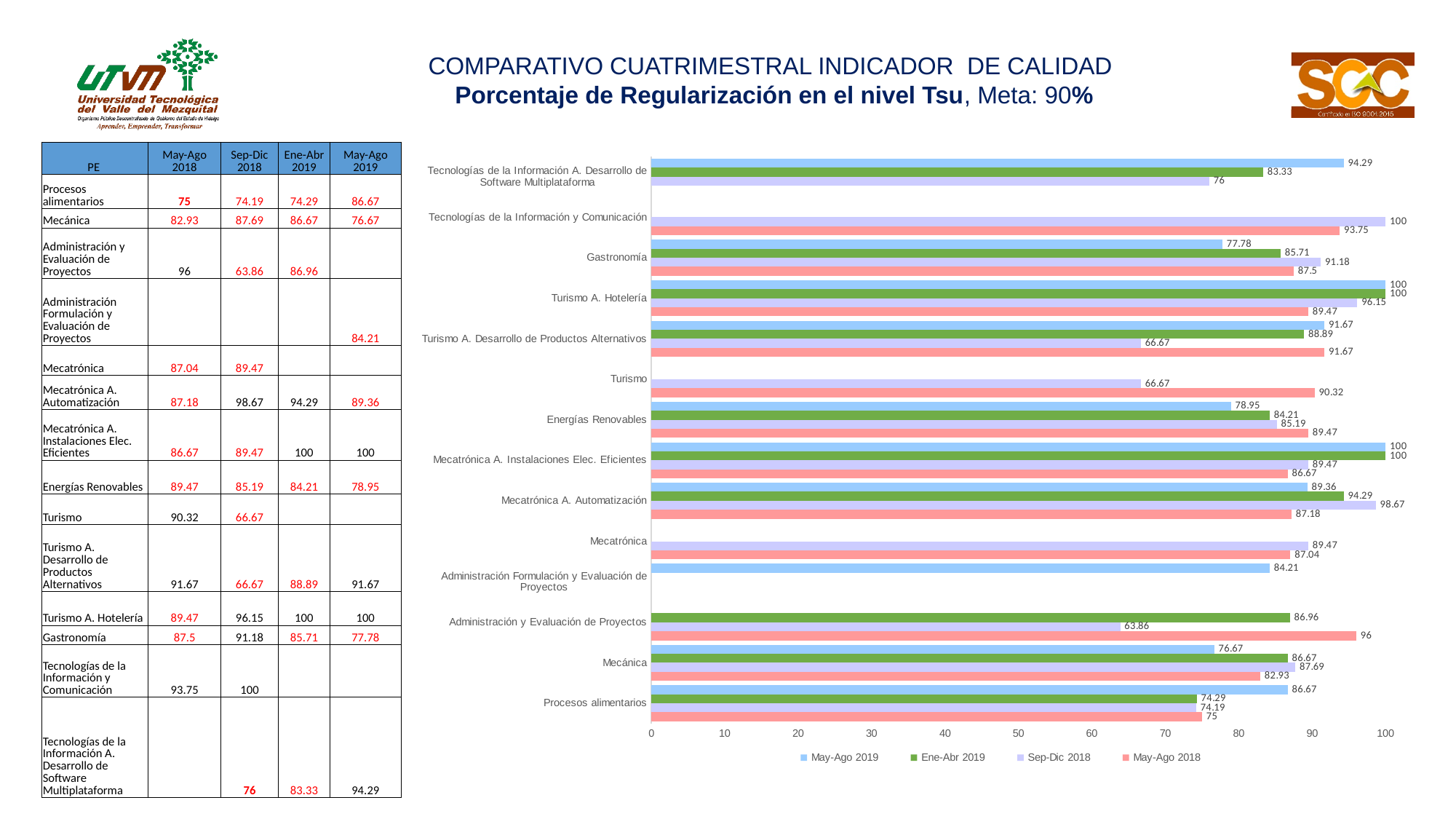
Which program has the highest May-Ago 2018 value? Administración y Evaluación de Proyectos What type of chart is shown on the slide? bar chart What colour represents the Ene-Abr 2019 series in the chart? green What is the May-Ago 2018 value for Procesos alimentarios? 75 How many programs (categories) are shown on the chart's vertical axis? 14 For Energías Renovables, what is the difference between the May-Ago 2018 value and the May-Ago 2019 value? 10.52 Is the Sep-Dic 2018 value for Administración y Evaluación de Proyectos greater or less than 70? less What is the Sep-Dic 2018 value for Turismo? 66.67 What is the Sep-Dic 2018 value for Mecatrónica A. Automatización? 98.67 What is the May-Ago 2019 value for Gastronomía? 77.78 For Mecánica, which is larger: the Sep-Dic 2018 value or the May-Ago 2019 value? Sep-Dic 2018 How many series does the chart legend list? 4